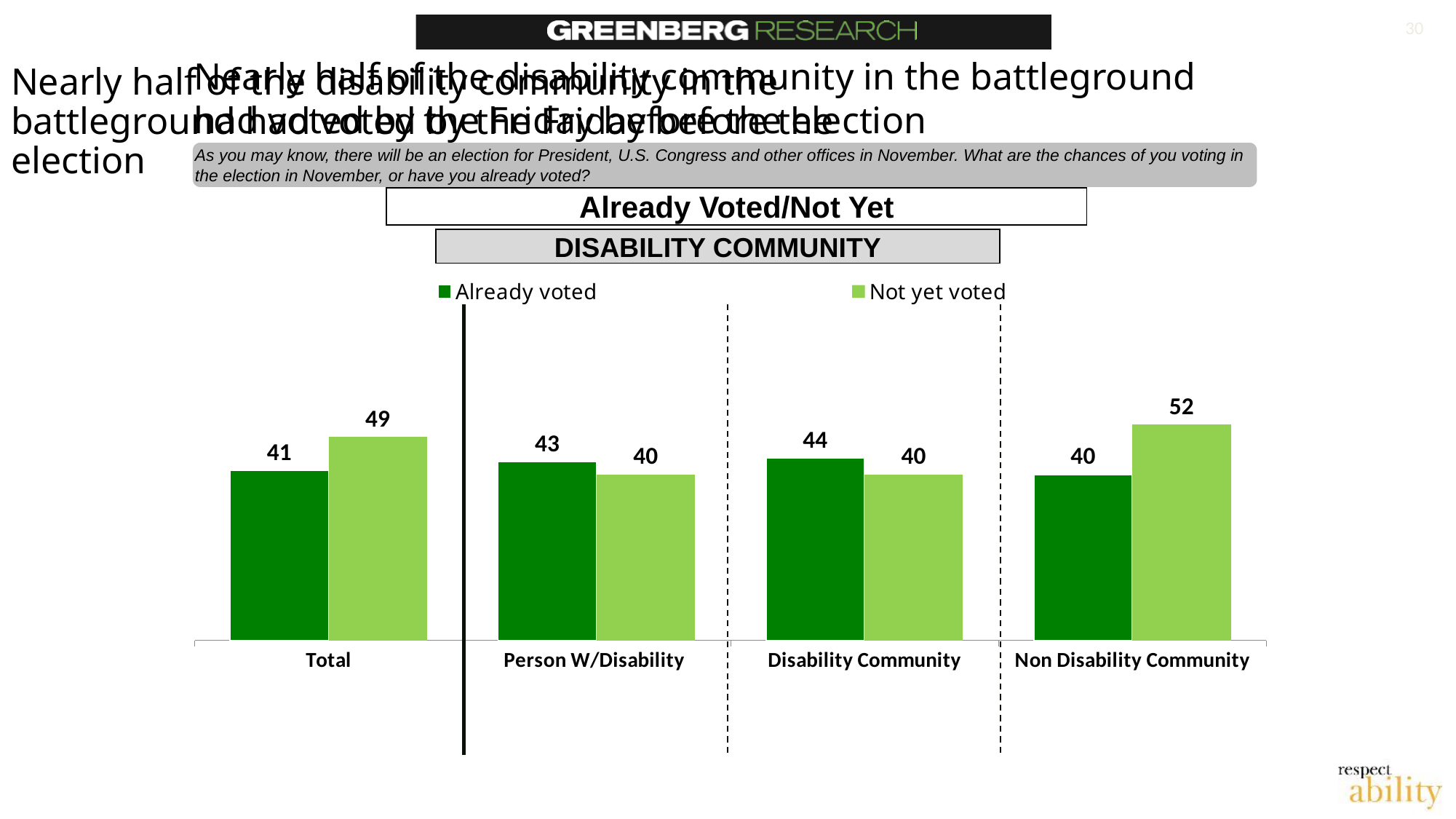
What is the value for Already voted in the Disability Community category? 44 What is the value for Not yet voted in the Person W/Disability category? 40 Which category has the highest Not yet voted value? Non Disability Community In the Disability Community category, which is larger: Already voted or Not yet voted? Already voted How many series does the legend list? 2 How many categories are shown on the x axis? 4 What is the difference between Not yet voted and Already voted in the Total category? 8 What is the difference between Not yet voted and Already voted in the Non Disability Community category? 12 What kind of chart is shown on the slide? Bar chart What is the value for Not yet voted in the Non Disability Community category? 52 What is the value for Already voted in the Total category? 41 Which category has the highest Already voted value? Disability Community